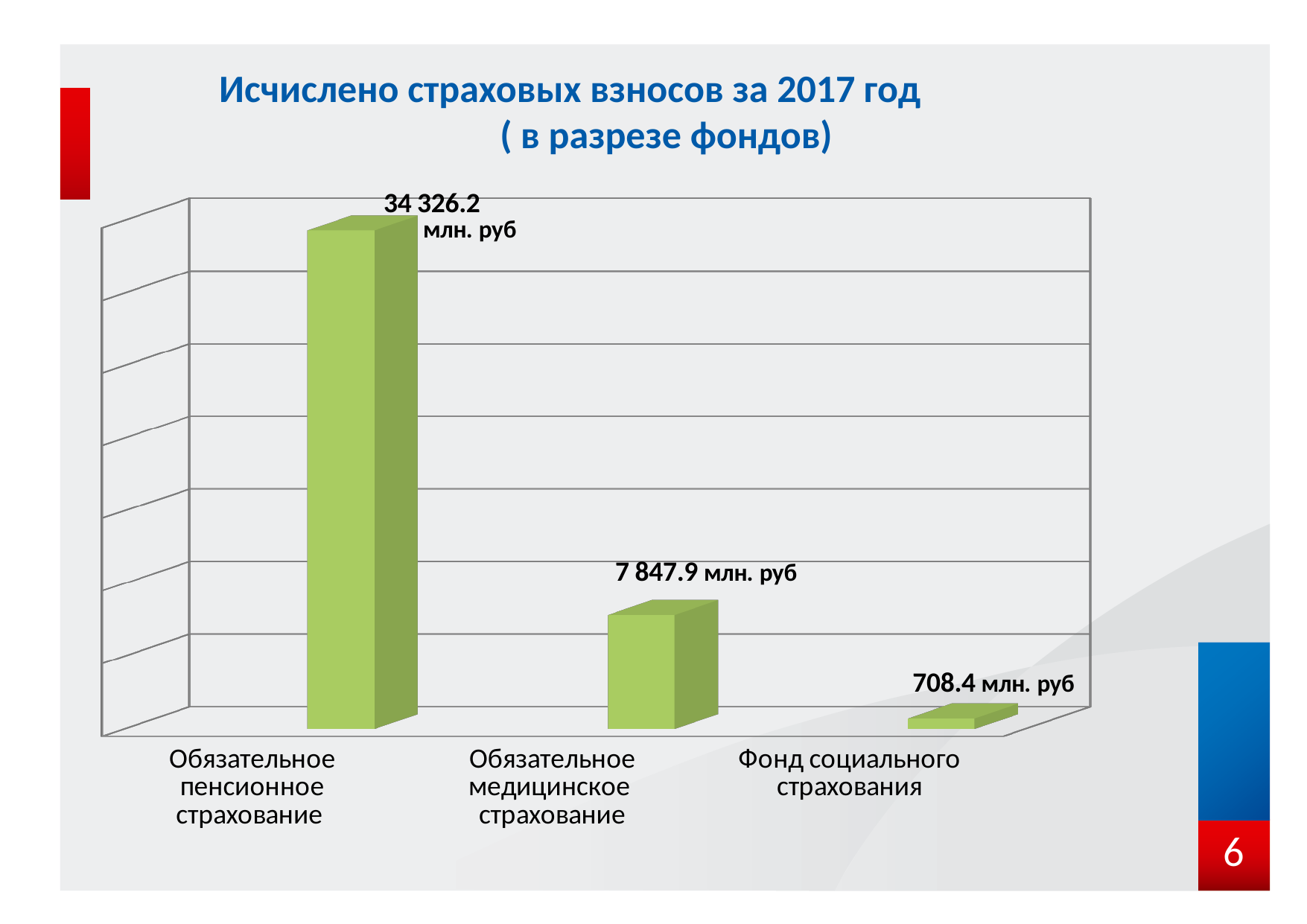
What value is shown for Обязательное пенсионное страхование? 34 326.2 млн. руб What is the difference between the values for Обязательное медицинское страхование and Фонд социального страхования? 7 139.5 млн. руб What is the difference between the values for Обязательное пенсионное страхование and Обязательное медицинское страхование? 26 478.3 млн. руб What value is shown for Фонд социального страхования? 708.4 млн. руб What kind of chart is shown on the slide? Bar chart Which category has the highest value? Обязательное пенсионное страхование Do the values rise or fall from left to right across the categories? Fall What value is shown for Обязательное медицинское страхование? 7 847.9 млн. руб Which is larger: the value for Обязательное медицинское страхование or for Фонд социального страхования? Обязательное медицинское страхование Which category has the lowest value? Фонд социального страхования What is the title of the chart on the slide? Исчислено страховых взносов за 2017 год ( в разрезе фондов) How many categories are shown in the chart? 3